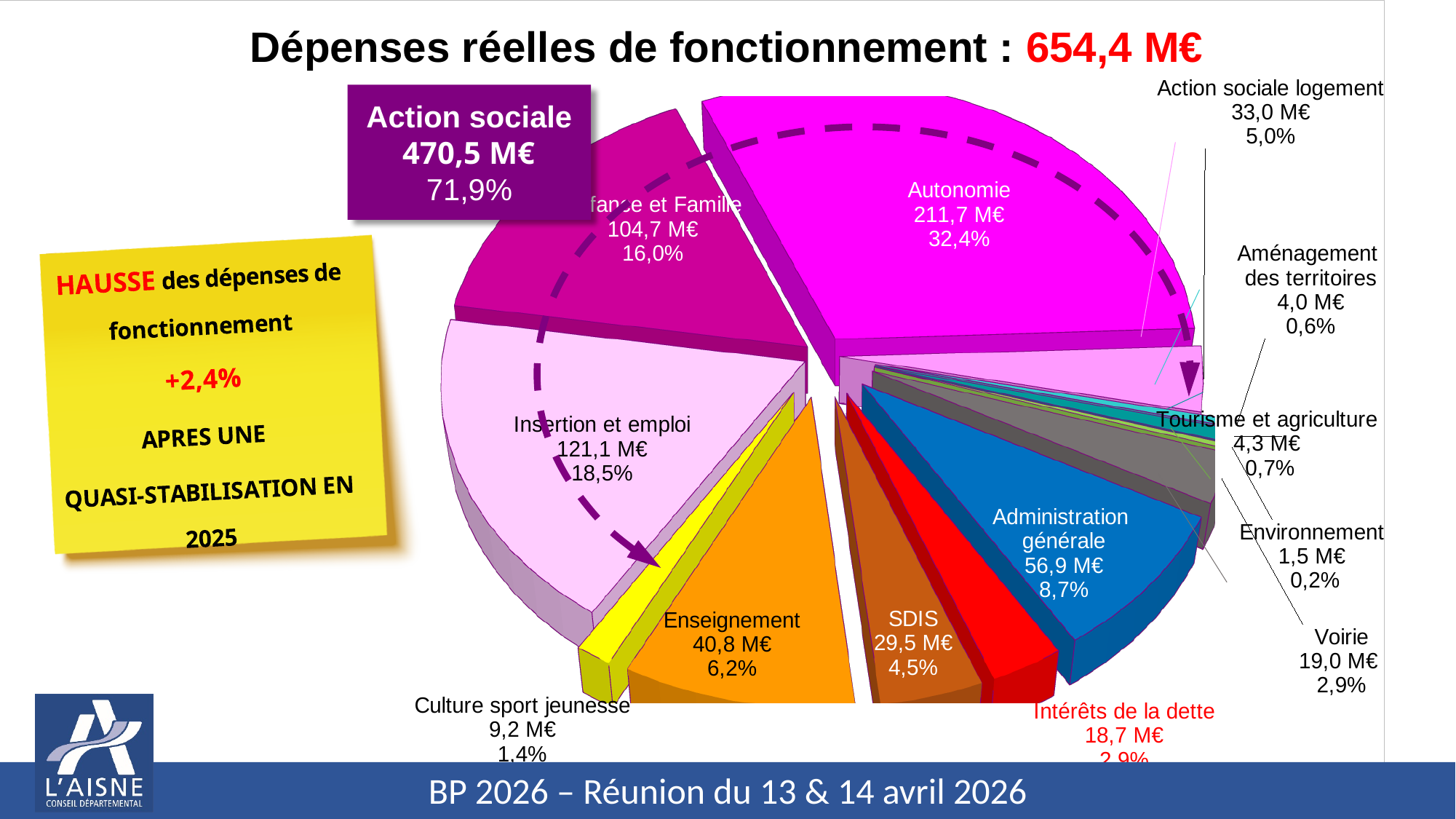
What is the value for Culture sport jeunesse? 9,2 M€ What kind of chart is shown on the slide? pie chart What share of the pie does Action sociale logement represent? 5,0% What is the total of real operating expenses given in the chart title? 654,4 M€ Which is larger, SDIS or Voirie? SDIS Which category has the smallest slice of the pie? Environnement How many categories are shown in the pie chart? 13 What share of the pie does Insertion et emploi represent? 18,5% What is the difference between Insertion et emploi and Enseignement? 80,3 M€ What is the value for Autonomie? 211,7 M€ What is the value for Administration générale? 56,9 M€ Which category has the largest slice of the pie? Autonomie